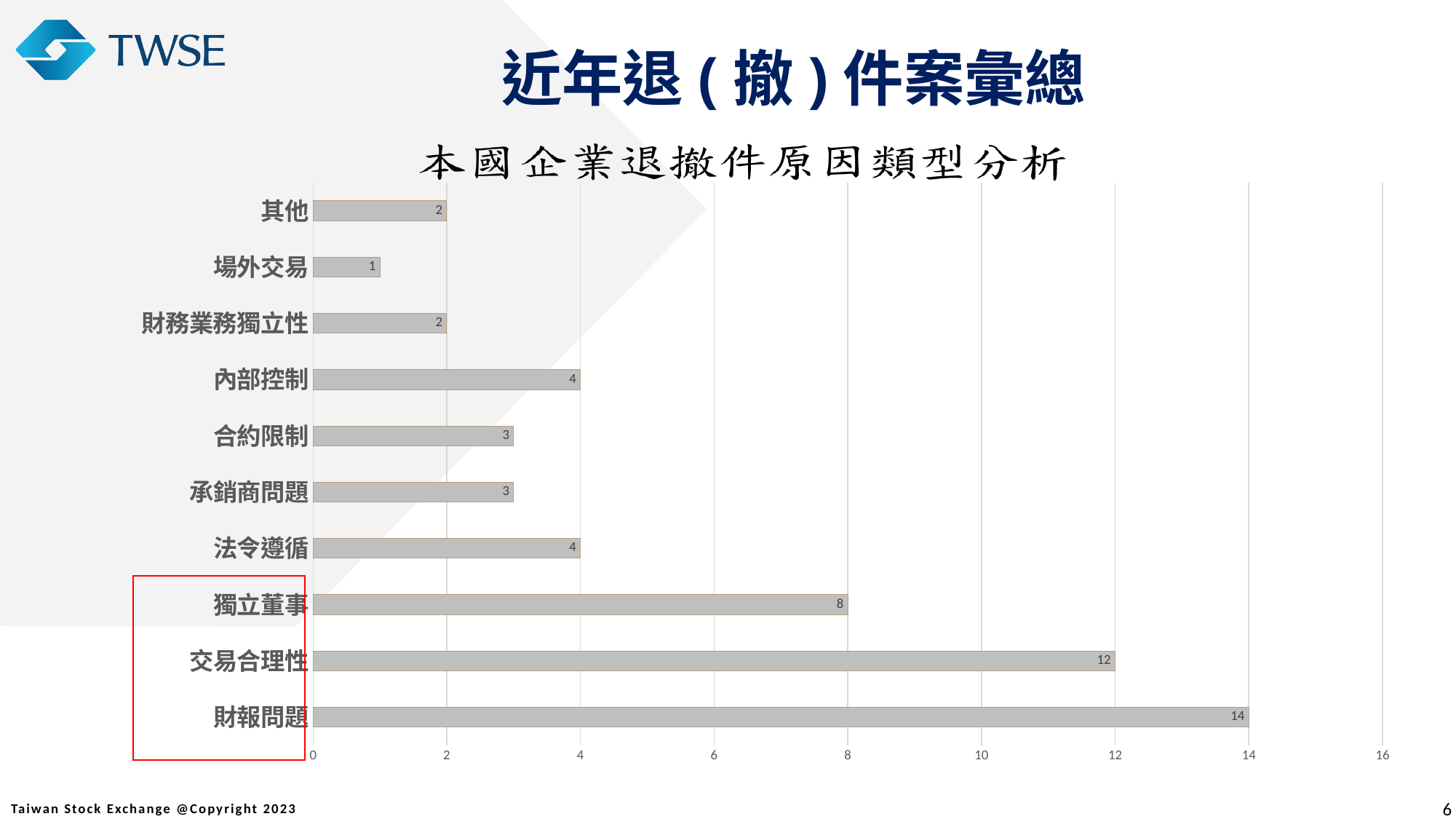
What is the value for 交易合理性? 12 What is the title of the chart? 本國企業退撤件原因類型分析 What is the value for 場外交易? 1 What is the value for 獨立董事? 8 Is the value for 獨立董事 greater or less than 6? greater What kind of chart is shown on the slide? bar chart Which category has the lowest value? 場外交易 Which category has the highest value? 財報問題 Which is larger, the value for 內部控制 or the value for 合約限制? 內部控制 What is the difference between the values for 財報問題 and 交易合理性? 2 How many categories are shown in the chart? 10 What is the value for 財報問題? 14